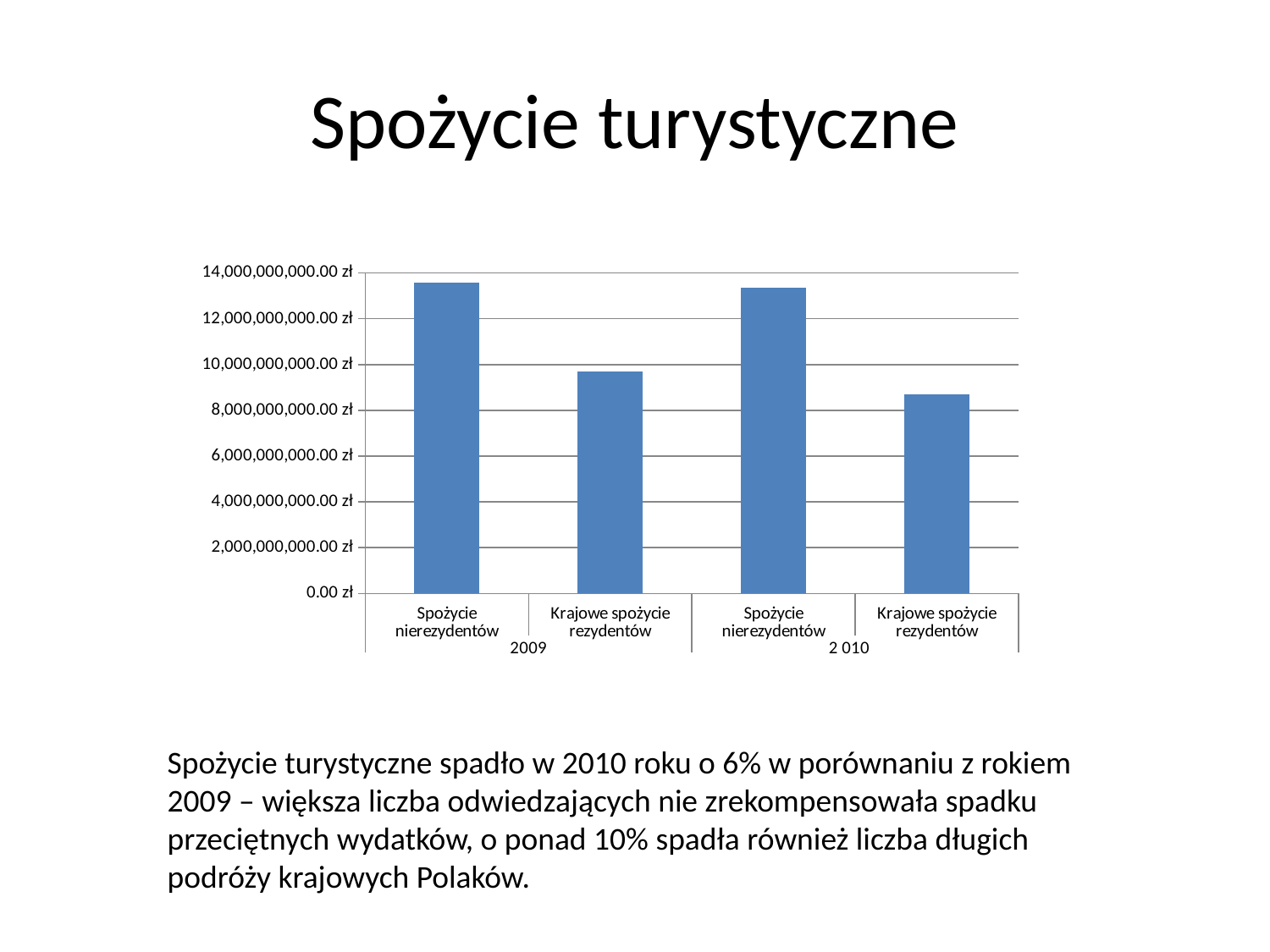
What kind of chart is shown on the slide? bar chart Which bar has the lowest value in the chart? Krajowe spożycie rezydentów (2010) What is the highest value shown on the vertical axis of the chart? 14,000,000,000.00 zł Which is larger: Krajowe spożycie rezydentów in 2009 or in 2010? 2009 Is the value for Spożycie nierezydentów in 2010 greater or less than 12,000,000,000.00 zł? greater Is the value for Spożycie nierezydentów in 2009 greater or less than 12,000,000,000.00 zł? greater Does Krajowe spożycie rezydentów rise or fall from 2009 to 2010? fall In 2009, which is larger: Spożycie nierezydentów or Krajowe spożycie rezydentów? Spożycie nierezydentów Is the value for Krajowe spożycie rezydentów in 2009 greater or less than 10,000,000,000.00 zł? less What is the title of the slide containing the chart? Spożycie turystyczne How many bars are plotted in the chart? 4